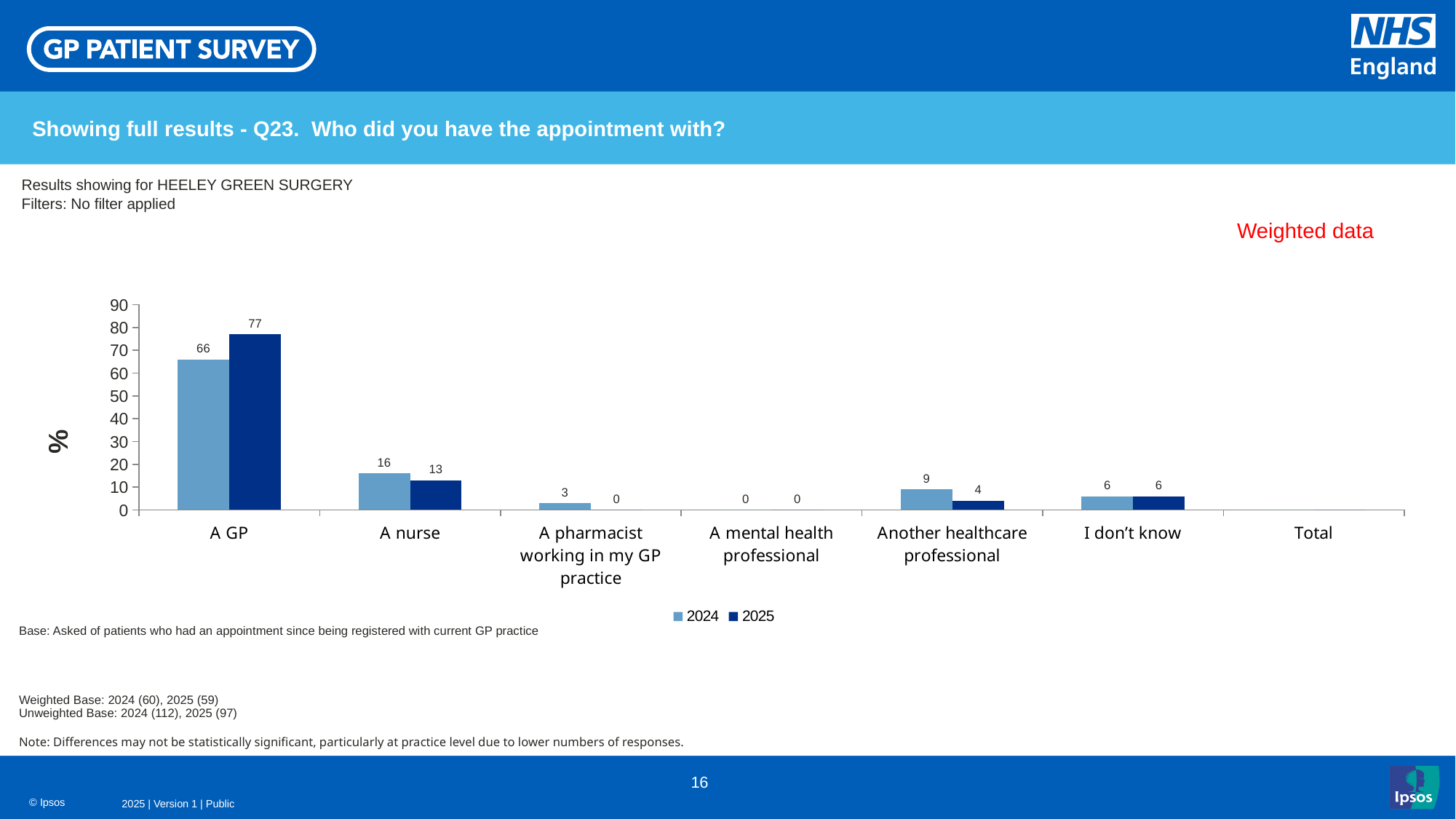
What is the 2025 value for A pharmacist working in my GP practice? 0 What is the 2024 value for Another healthcare professional? 9 What is the difference between the 2024 and 2025 values for Another healthcare professional? 5 What is the 2024 value for A nurse? 16 What is the label on the vertical axis? % What kind of chart is shown on the slide? Bar chart What is the difference between the 2025 and 2024 values for A GP? 11 What are the two series listed in the legend? 2024 and 2025 What is the 2025 value for A GP? 77 How many series does the legend list? 2 Which category has the highest 2024 value? A GP Which is larger for A nurse, the 2024 value or the 2025 value? 2024